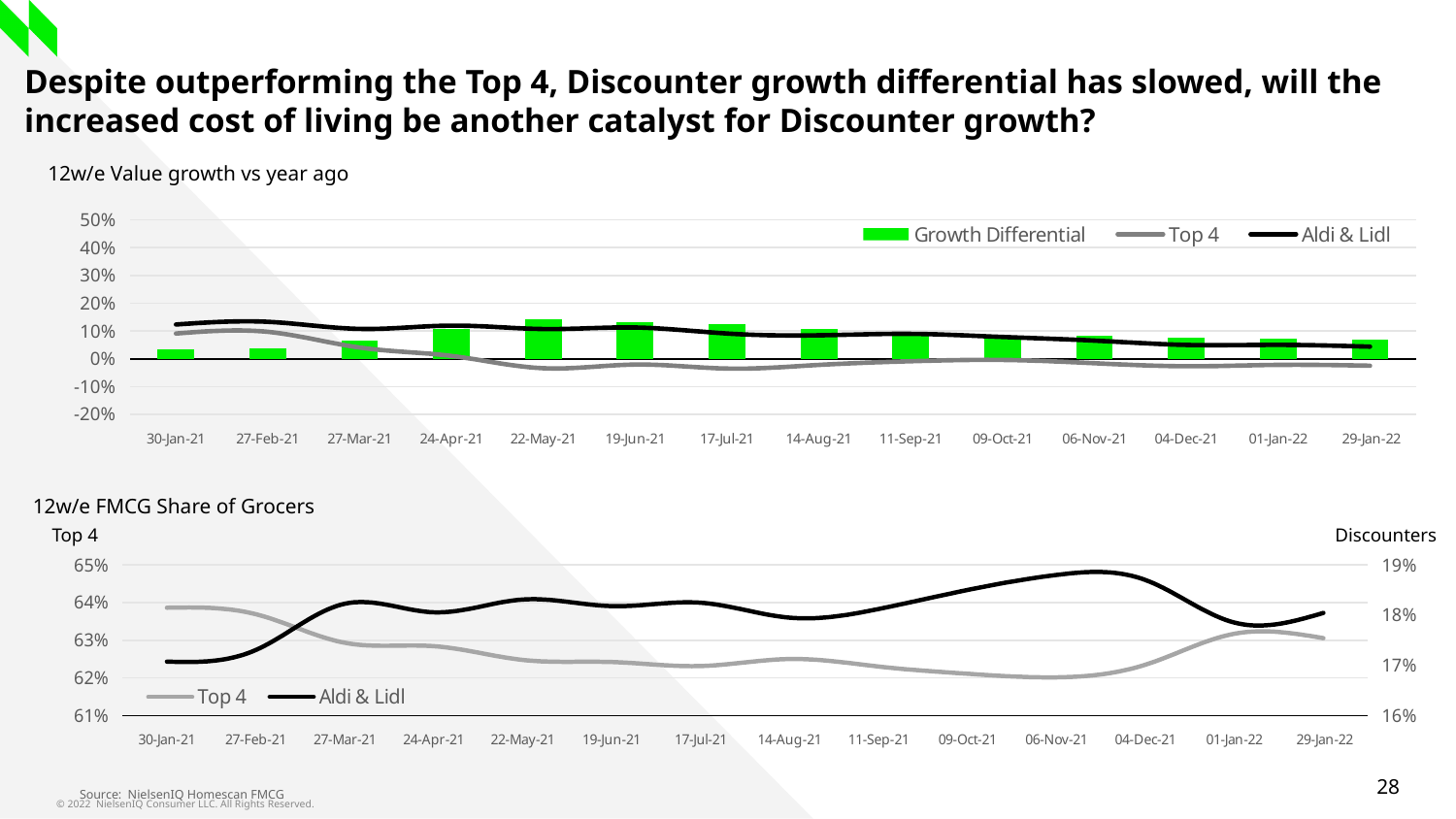
On the '12w/e Value growth vs year ago' chart, how many dates are shown on the x axis? 14 On the '12w/e Value growth vs year ago' chart, what colour are the Growth Differential bars? Green On the '12w/e FMCG Share of Grocers' chart, does the Top 4 line rise or fall from 30-Jan-21 to 06-Nov-21? fall On the '12w/e Value growth vs year ago' chart, at which date is the Growth Differential bar highest? 22-May-21 On the '12w/e Value growth vs year ago' chart, is the Top 4 value at 22-May-21 greater or less than 0%? less On the '12w/e FMCG Share of Grocers' chart, is the Top 4 share at 22-May-21 greater or less than 63%? less On the '12w/e Value growth vs year ago' chart, which is higher at 30-Jan-21, Top 4 or Aldi & Lidl? Aldi & Lidl On the '12w/e Value growth vs year ago' chart, is the Aldi & Lidl value at 30-Jan-21 greater or less than 10%? greater On the '12w/e FMCG Share of Grocers' chart, at which date does the Aldi & Lidl line reach its highest point? 06-Nov-21 On the '12w/e Value growth vs year ago' chart, does the Aldi & Lidl line rise or fall overall from 30-Jan-21 to 29-Jan-22? fall On the '12w/e Value growth vs year ago' chart, how many series does the legend list? 3 What kind of chart is the '12w/e FMCG Share of Grocers' chart? Line chart